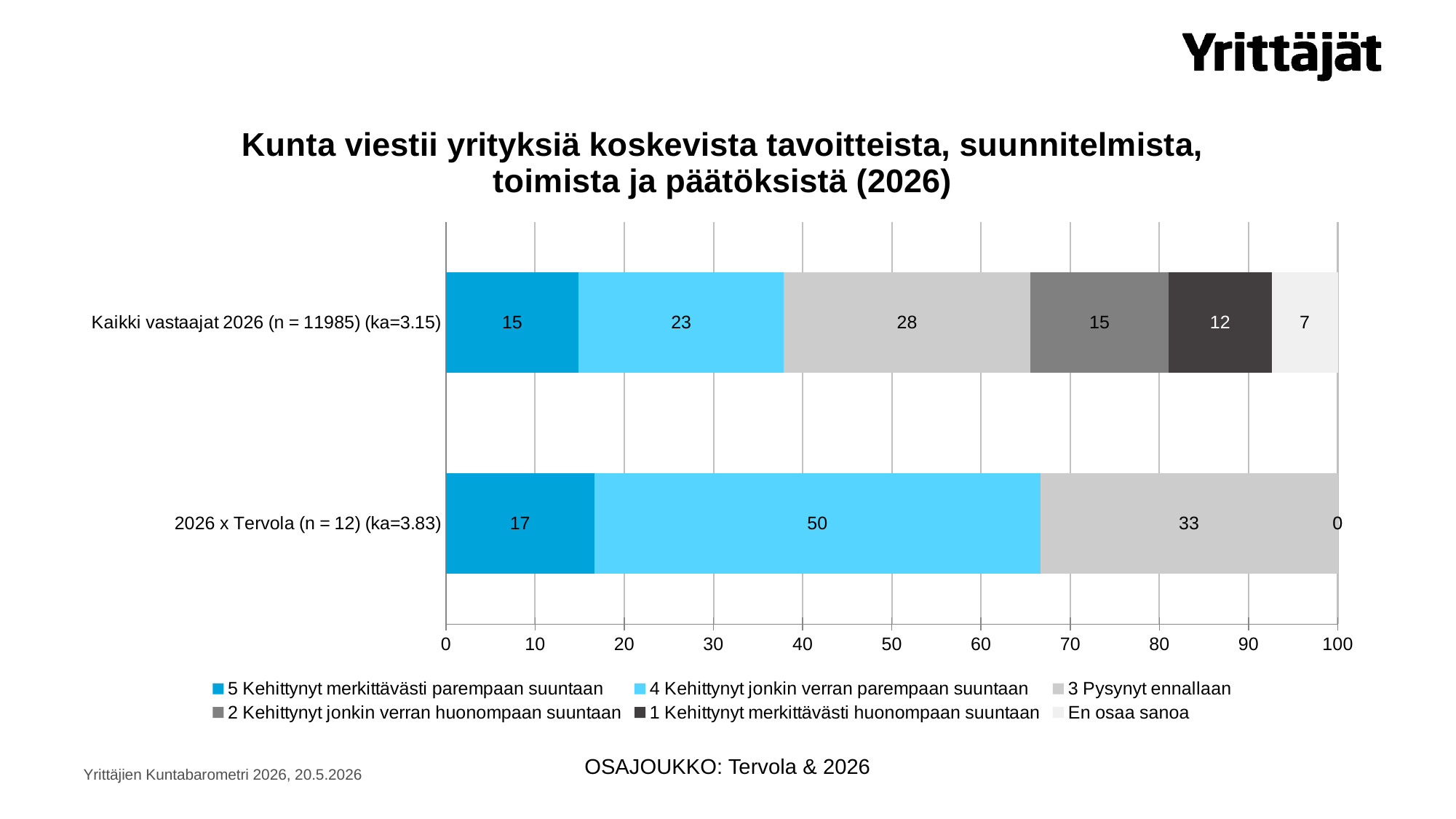
What is the value of '1 Kehittynyt merkittävästi huonompaan suuntaan' for 'Kaikki vastaajat 2026 (n = 11985) (ka=3.15)'? 12 What is the difference between the '4 Kehittynyt jonkin verran parempaan suuntaan' values for '2026 x Tervola (n = 12) (ka=3.83)' and 'Kaikki vastaajat 2026 (n = 11985) (ka=3.15)'? 27 What is the value of '4 Kehittynyt jonkin verran parempaan suuntaan' for '2026 x Tervola (n = 12) (ka=3.83)'? 50 What kind of chart is shown on the slide? stacked bar chart What is the total of the stacked bar for 'Kaikki vastaajat 2026 (n = 11985) (ka=3.15)'? 100 What is the value of '5 Kehittynyt merkittävästi parempaan suuntaan' for 'Kaikki vastaajat 2026 (n = 11985) (ka=3.15)'? 15 How many categories (bars) are shown in the chart? 2 Which category has the larger value for '5 Kehittynyt merkittävästi parempaan suuntaan': 'Kaikki vastaajat 2026 (n = 11985) (ka=3.15)' or '2026 x Tervola (n = 12) (ka=3.83)'? 2026 x Tervola (n = 12) (ka=3.83) What is the value of '3 Pysynyt ennallaan' for '2026 x Tervola (n = 12) (ka=3.83)'? 33 How many series does the legend list? 6 What is the value of 'En osaa sanoa' for 'Kaikki vastaajat 2026 (n = 11985) (ka=3.15)'? 7 Which series has the largest value in the 'Kaikki vastaajat 2026 (n = 11985) (ka=3.15)' bar? 3 Pysynyt ennallaan